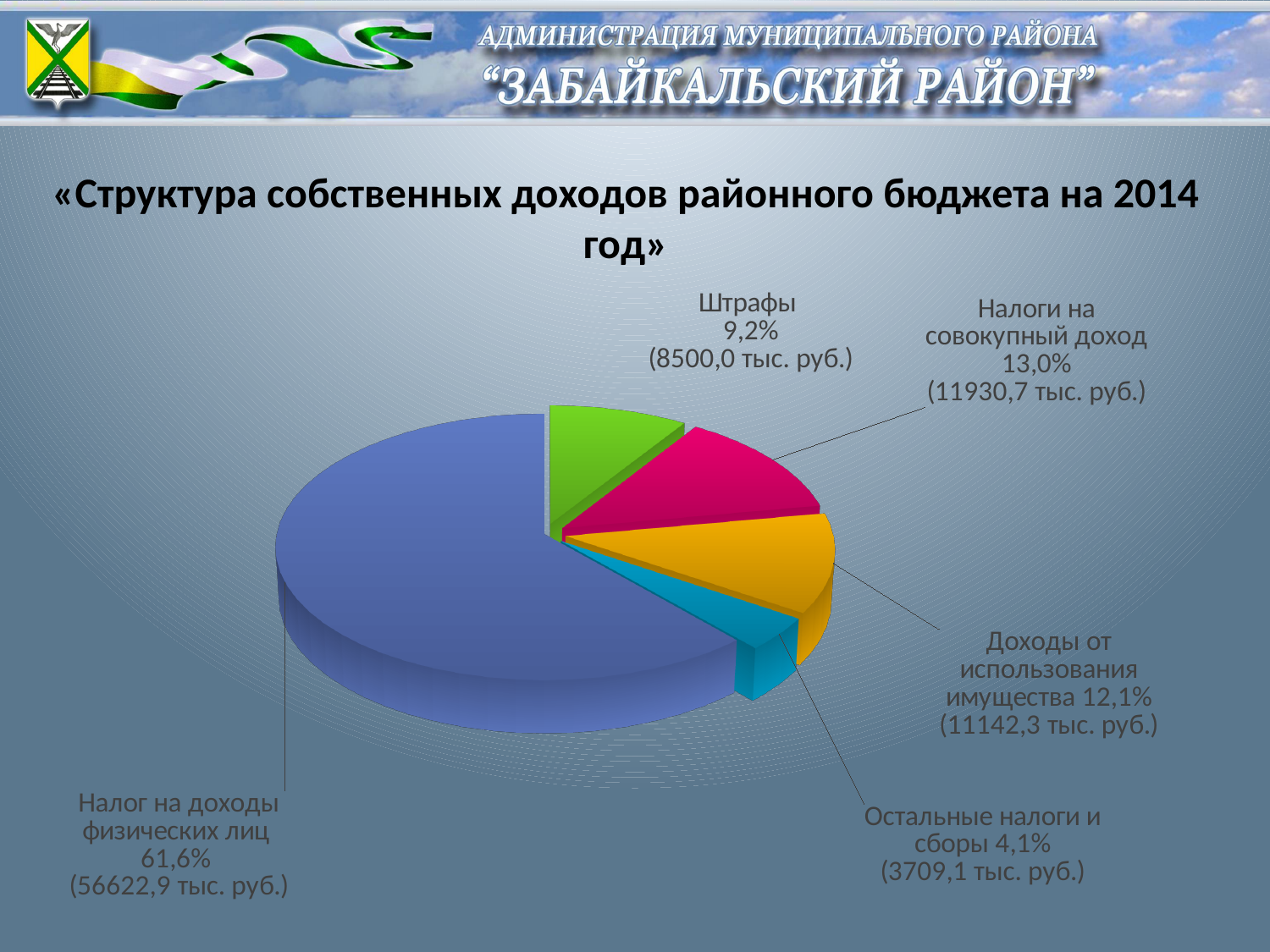
What is the value in thousand rubles for 'Налоги на совокупный доход'? 11930,7 тыс. руб. What is the title of the chart? «Структура собственных доходов районного бюджета на 2014 год» What is the difference in percentage points between 'Налог на доходы физических лиц' and 'Штрафы'? 52,4 Which category has the smallest share of the pie? Остальные налоги и сборы What is the value in thousand rubles for 'Остальные налоги и сборы'? 3709,1 тыс. руб. Which is larger: 'Налоги на совокупный доход' or 'Доходы от использования имущества'? Налоги на совокупный доход What share of the pie is 'Налог на доходы физических лиц'? 61,6% What is the value in thousand rubles for 'Штрафы'? 8500,0 тыс. руб. What type of chart is shown on the slide? Pie chart Which category has the largest share of the pie? Налог на доходы физических лиц How many slices does the pie chart have? 5 What percentage is shown for 'Доходы от использования имущества'? 12,1%